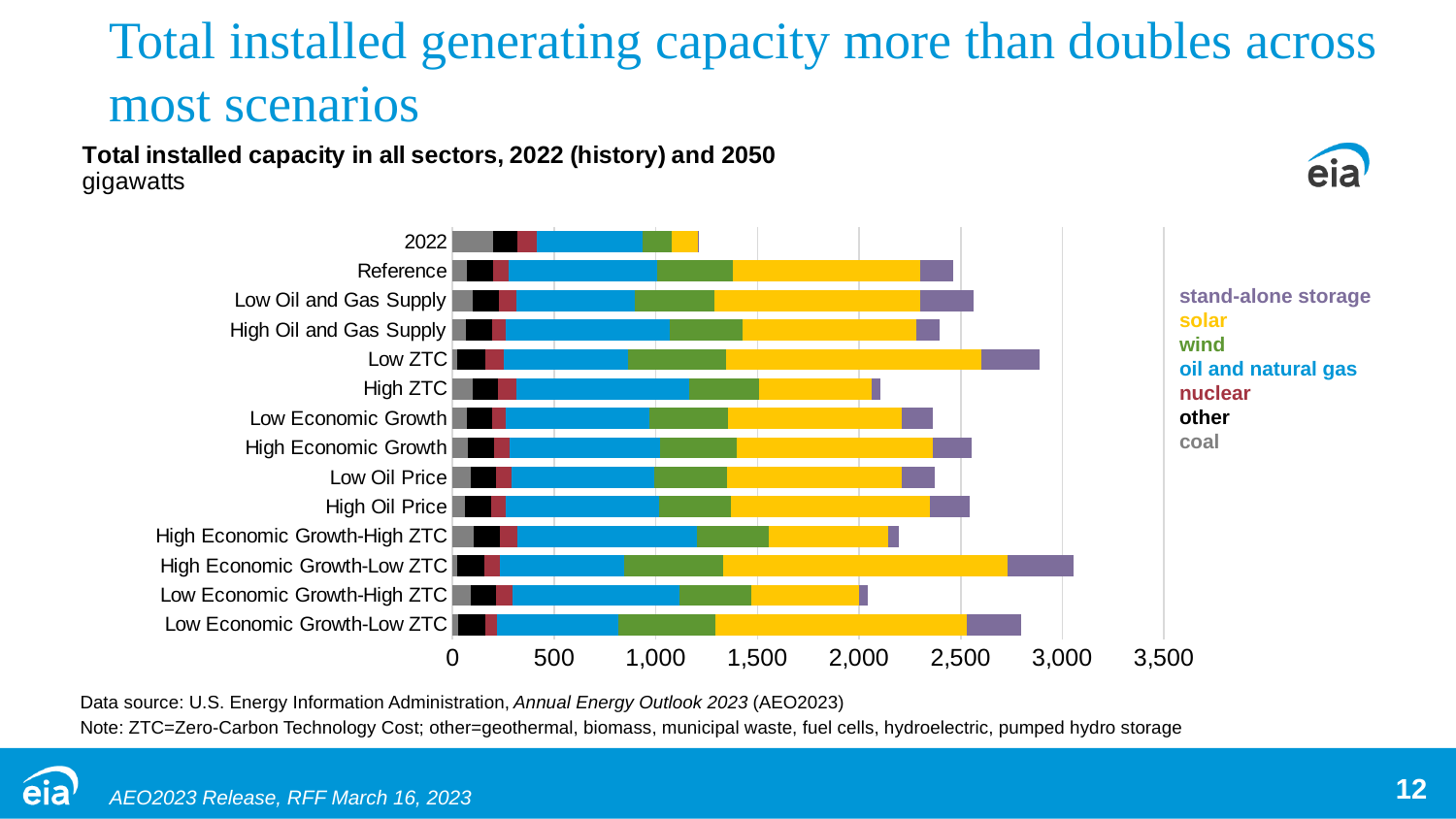
How many series does the legend list? 7 How many categories (years/scenarios) are plotted on the chart? 14 Is the total installed capacity for Reference greater or less than 2,000 gigawatts? greater Which has the larger total installed capacity, Low ZTC or High ZTC? Low ZTC What kind of chart is shown on the slide? stacked bar chart Which category has the longest total bar? High Economic Growth-Low ZTC Which has the larger total installed capacity, High Economic Growth-Low ZTC or Low Economic Growth-High ZTC? High Economic Growth-Low ZTC Is the total installed capacity for Low ZTC greater or less than 2,500 gigawatts? greater What unit is the chart measured in? gigawatts Which category has the shortest total bar? 2022 Is the total installed capacity for High ZTC greater or less than 2,500 gigawatts? less